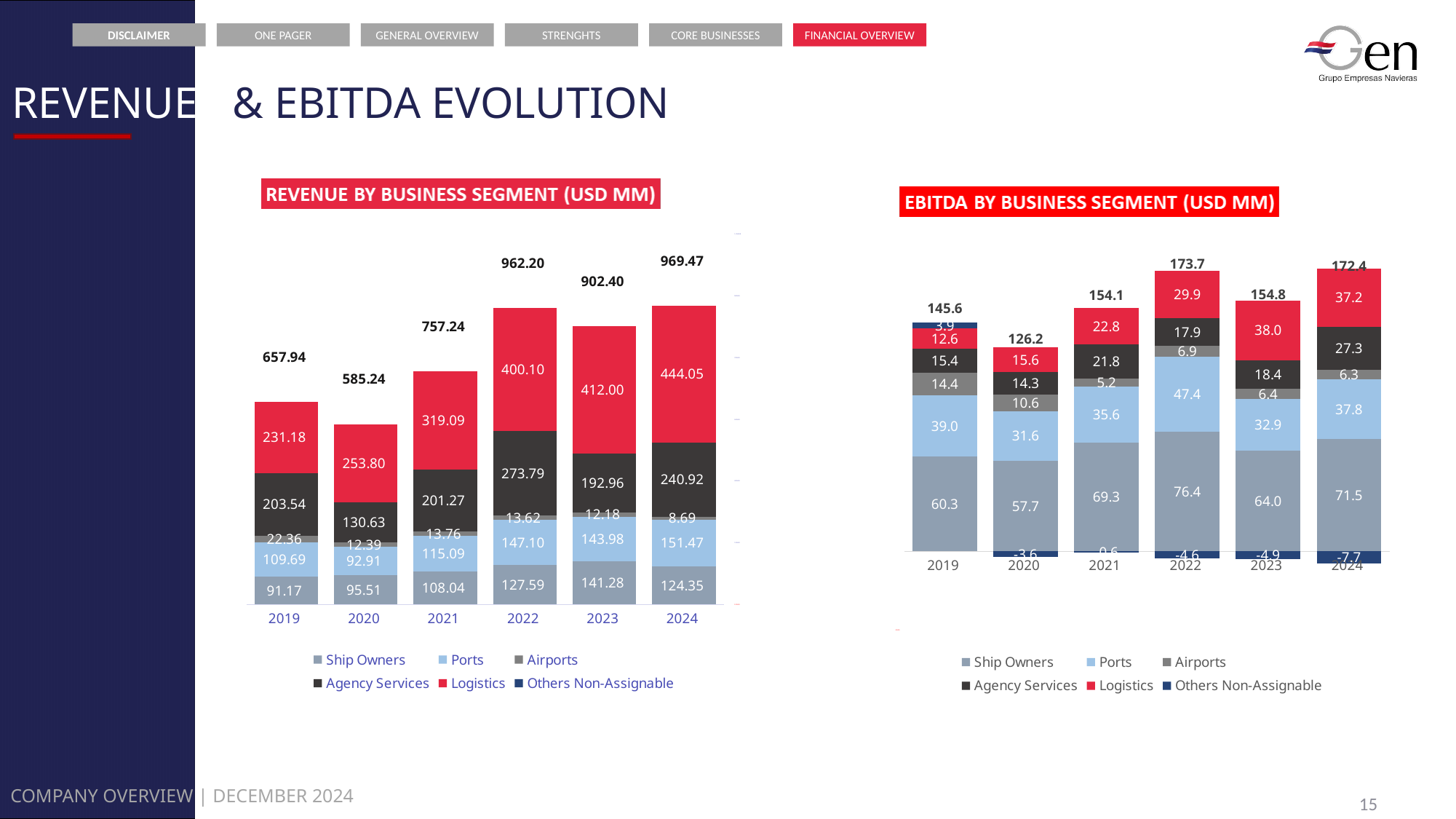
In the EBITDA by Business Segment chart, what is the difference between the Logistics EBITDA in 2023 and in 2019? 25.4 In the Revenue by Business Segment chart, what is the total revenue for 2024? 969.47 How many series does the legend of the EBITDA by Business Segment chart list? 6 In the EBITDA by Business Segment chart, what is the Ship Owners EBITDA in 2022? 76.4 In the EBITDA by Business Segment chart, what is the Others Non-Assignable value in 2024? -7.7 In the Revenue by Business Segment chart, which year has the lowest total revenue? 2020 How many years are shown on the x axis of the Revenue by Business Segment chart? 6 In the Revenue by Business Segment chart, what is the Logistics revenue in 2022? 400.10 In the Revenue by Business Segment chart, which is larger in 2021: Ports revenue or Ship Owners revenue? Ports In the Revenue by Business Segment chart, what is the difference between the Ship Owners revenue in 2023 and in 2019? 50.11 What type of chart is the Revenue by Business Segment chart? Stacked bar chart In the EBITDA by Business Segment chart, which year has the highest total EBITDA? 2022